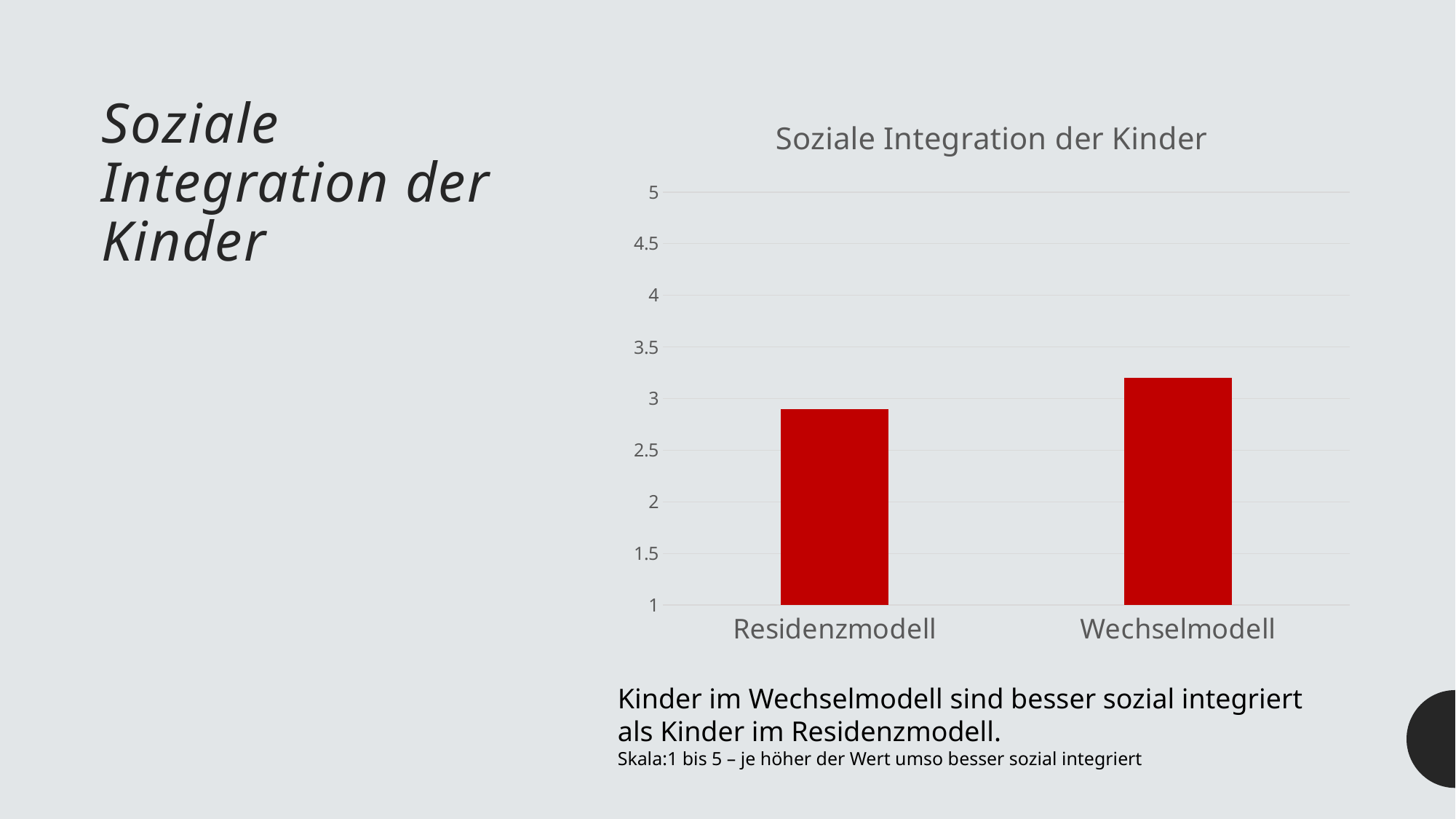
Is the value for Wechselmodell greater or less than 3.5? less Is the value for Wechselmodell greater or less than 3? greater What is the highest value shown on the y axis of the chart? 5 Which category has the highest value in the chart? Wechselmodell What kind of chart is shown on the slide? bar chart Is the value for Residenzmodell greater or less than 3? less Which category has the lowest value in the chart? Residenzmodell How many categories are shown on the x axis of the chart? 2 Do the values rise or fall from Residenzmodell to Wechselmodell? rise What is the title of the chart? Soziale Integration der Kinder Which is larger, the value for Residenzmodell or the value for Wechselmodell? Wechselmodell